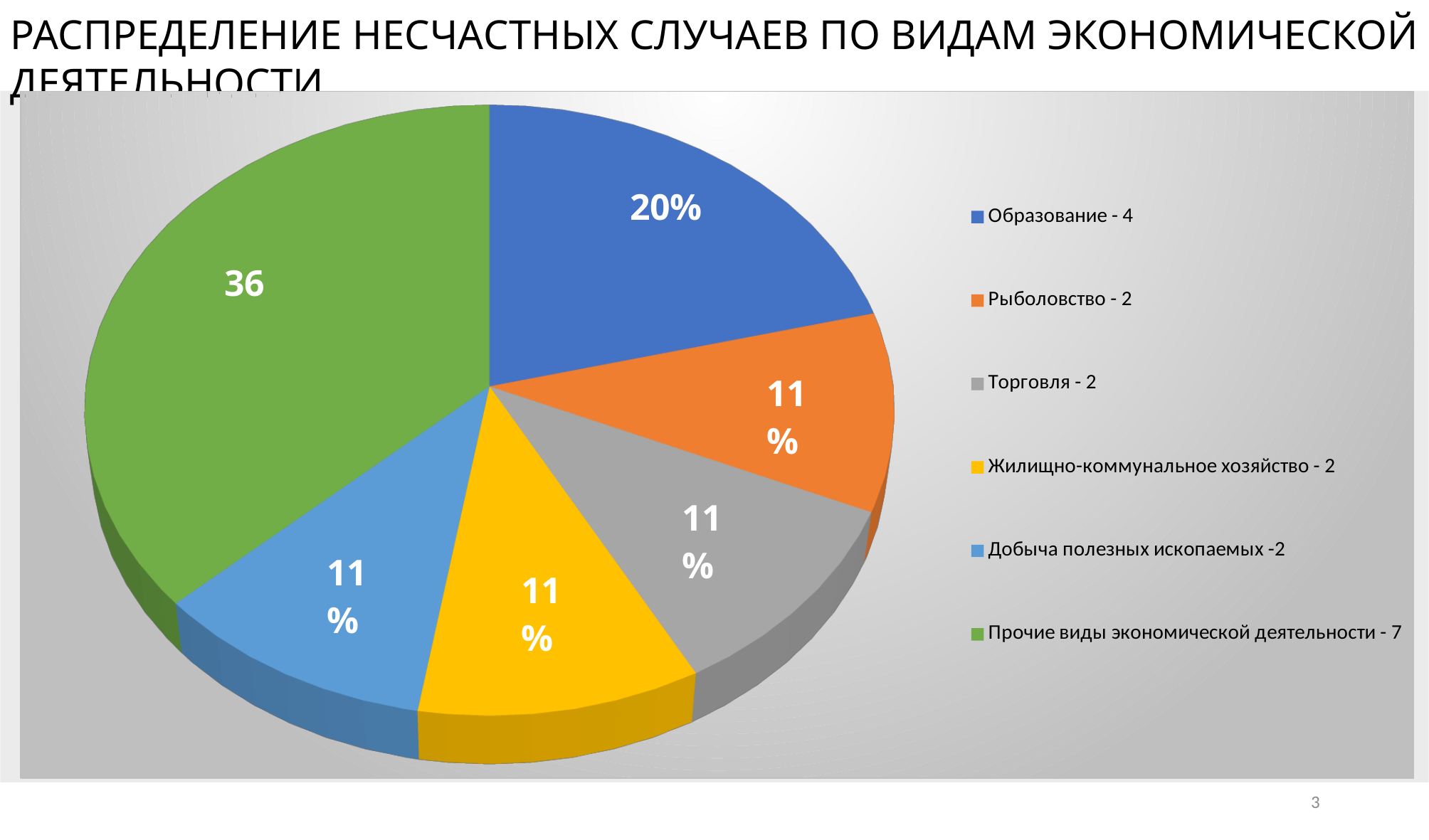
What label is printed on the green slice (Прочие виды экономической деятельности)? 36 What percentage is shown for the Рыболовство slice? 11% How many slices does the pie chart have? 6 What percentage is shown for the Торговля slice? 11% What kind of chart is shown on the slide? pie chart Which category has the largest slice of the pie? Прочие виды экономической деятельности What percentage is shown for the Образование slice? 20% What colour is the slice for Прочие виды экономической деятельности? green How many entries does the legend list? 6 What number is shown next to Образование in the legend? 4 Which slice is larger, Образование or Добыча полезных ископаемых? Образование What is the difference in percentage points between the Образование slice and the Жилищно-коммунальное хозяйство slice? 9%